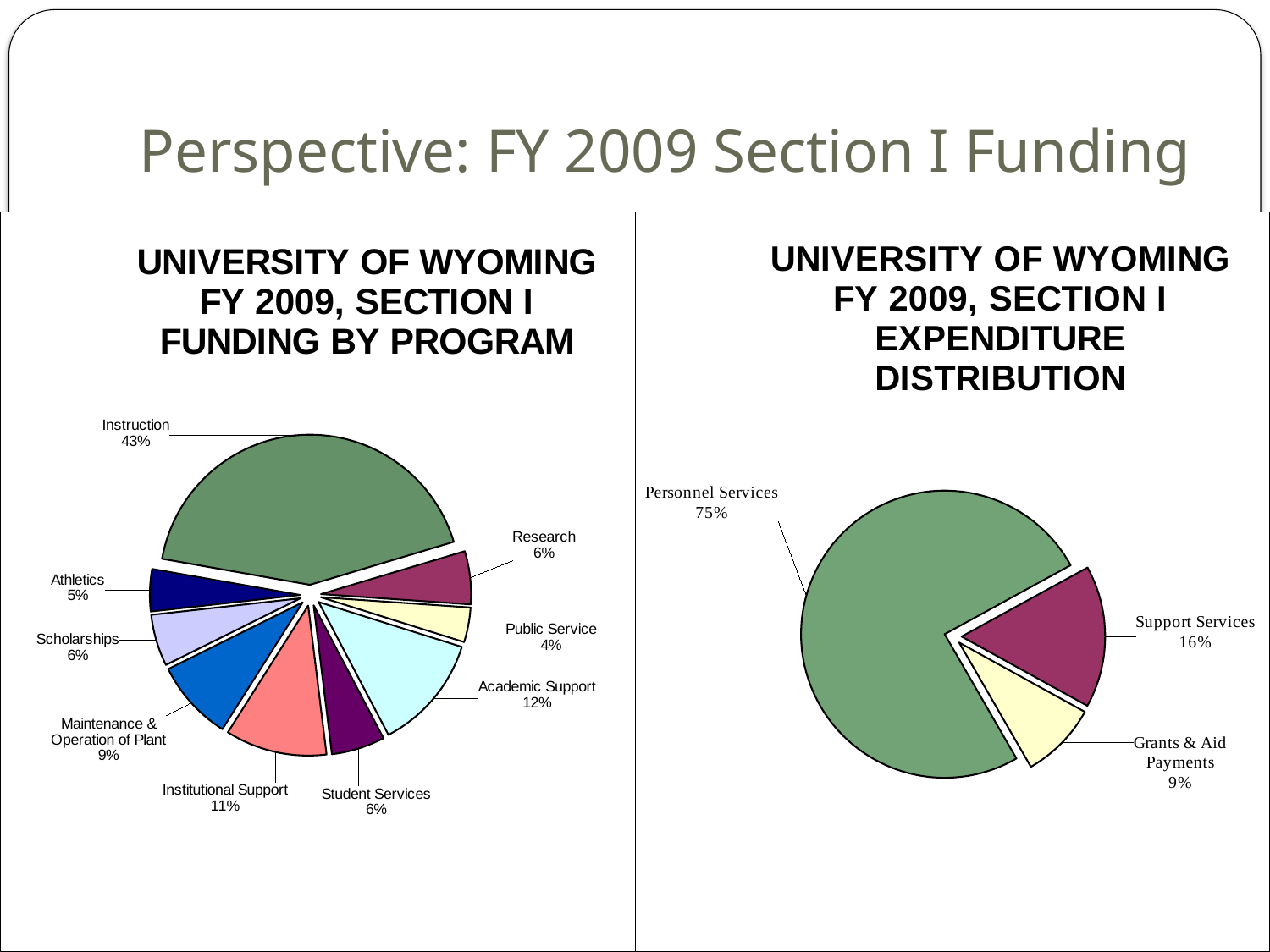
In the 'Expenditure Distribution' pie chart on the right, what share does Grants & Aid Payments have? 9% In the 'Funding by Program' pie chart on the left, which is larger: Maintenance & Operation of Plant or Athletics? Maintenance & Operation of Plant In the 'Funding by Program' pie chart on the left, what share does Academic Support have? 12% In the 'Expenditure Distribution' pie chart on the right, what share does Personnel Services have? 75% In the 'Funding by Program' pie chart on the left, which category has the largest share? Instruction What type of chart is used on the right side of the slide? Pie chart In the 'Funding by Program' pie chart on the left, which category has the smallest share? Public Service In the 'Funding by Program' pie chart on the left, what is the difference in percentage points between Instruction and Institutional Support? 32 In the 'Funding by Program' pie chart on the left, how many categories are shown? 9 In the 'Expenditure Distribution' pie chart on the right, what is the difference in percentage points between Support Services and Grants & Aid Payments? 7 In the 'Expenditure Distribution' pie chart on the right, how many categories are shown? 3